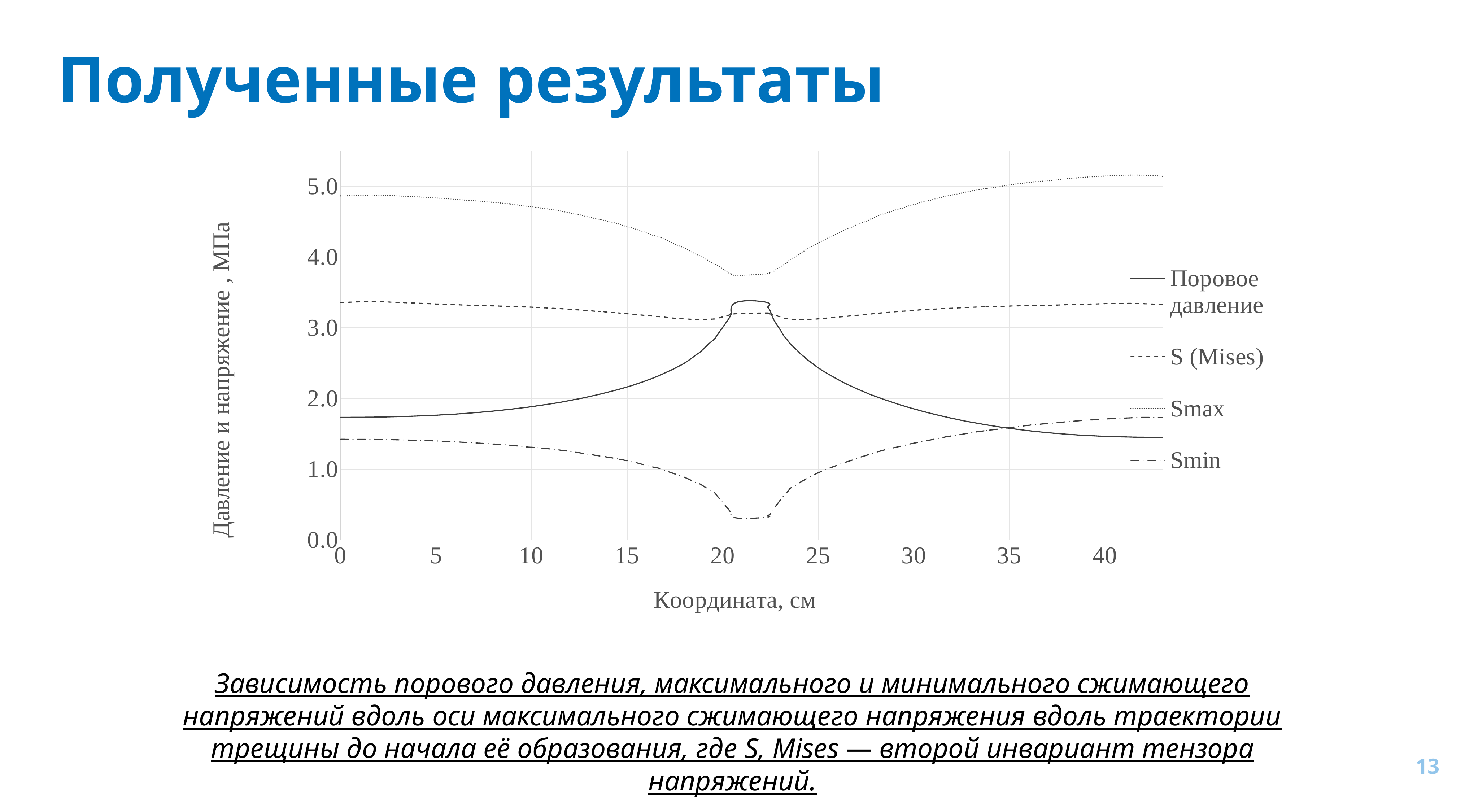
How many series does the legend list? 4 Is the value of S (Mises) at coordinate 0 greater or less than 3.0? greater What kind of chart is shown on the slide? line chart Is the lowest value of Smin, near coordinate 21, greater or less than 1.0? less At coordinate 40, which is larger: Smin or Поровое давление? Smin Which series is drawn with a solid line according to the legend? Поровое давление Which series has the highest values across the whole coordinate range? Smax Is the value of Smax at coordinate 0 greater or less than 4.0? greater Does Smax rise or fall as the coordinate increases from 25 to 40? rise What is the label of the x axis? Координата, см